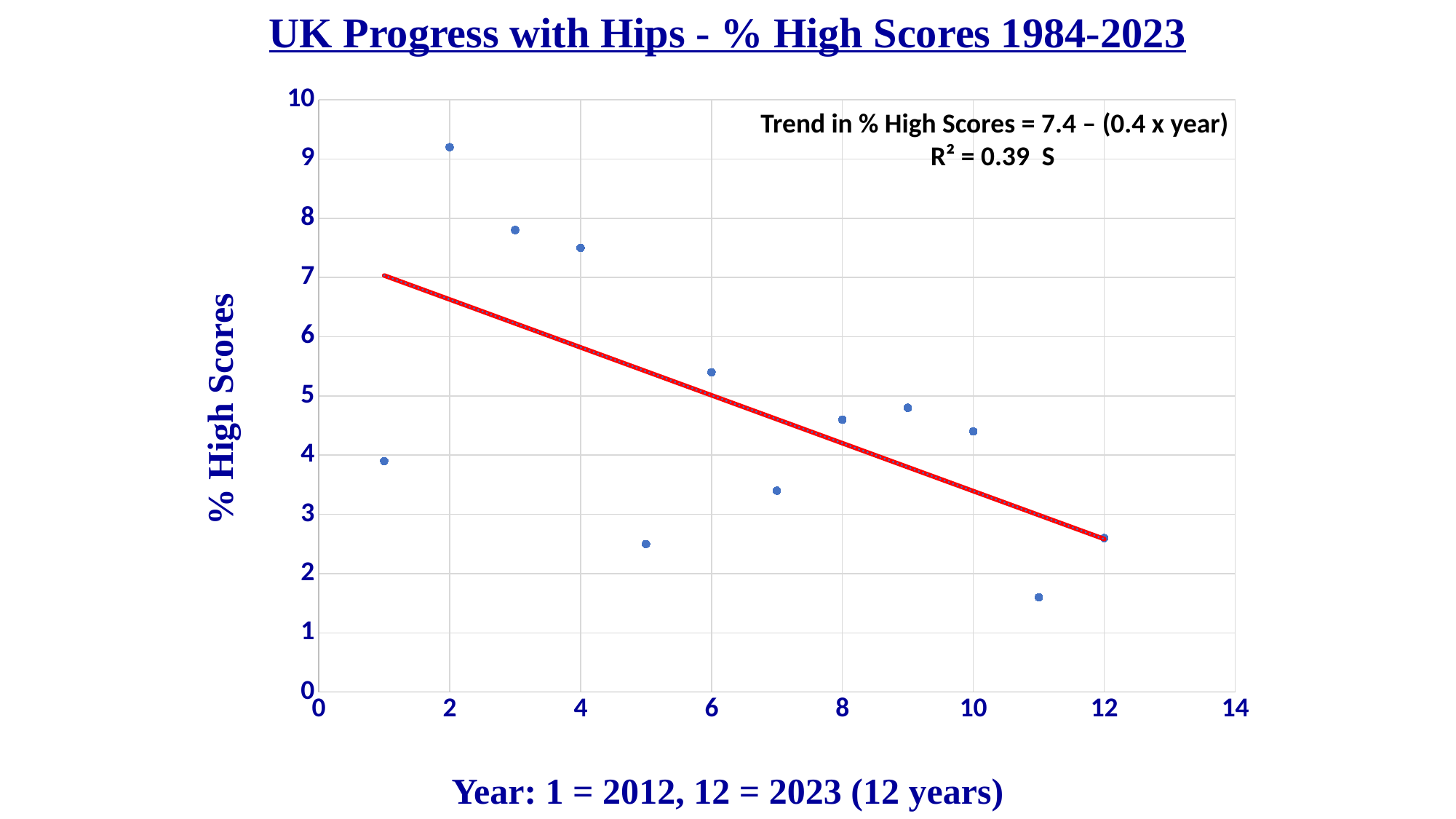
Is the % High Scores value for year 5 greater or less than 3? less Is the % High Scores value for year 11 greater or less than 2? less Which year has the highest % High Scores value? Year 2 Do the % High Scores values generally rise or fall as the year increases along the x axis? Fall Is the % High Scores value for year 3 greater or less than 7? greater Which year has the lowest % High Scores value? Year 11 What R² value is printed on the chart? 0.39 What kind of chart is shown on the slide? Scatter chart How many data points are plotted on the chart? 12 What is the trend equation printed on the chart? Trend in % High Scores = 7.4 – (0.4 x year) Which has the higher % High Scores value, year 3 or year 7? Year 3